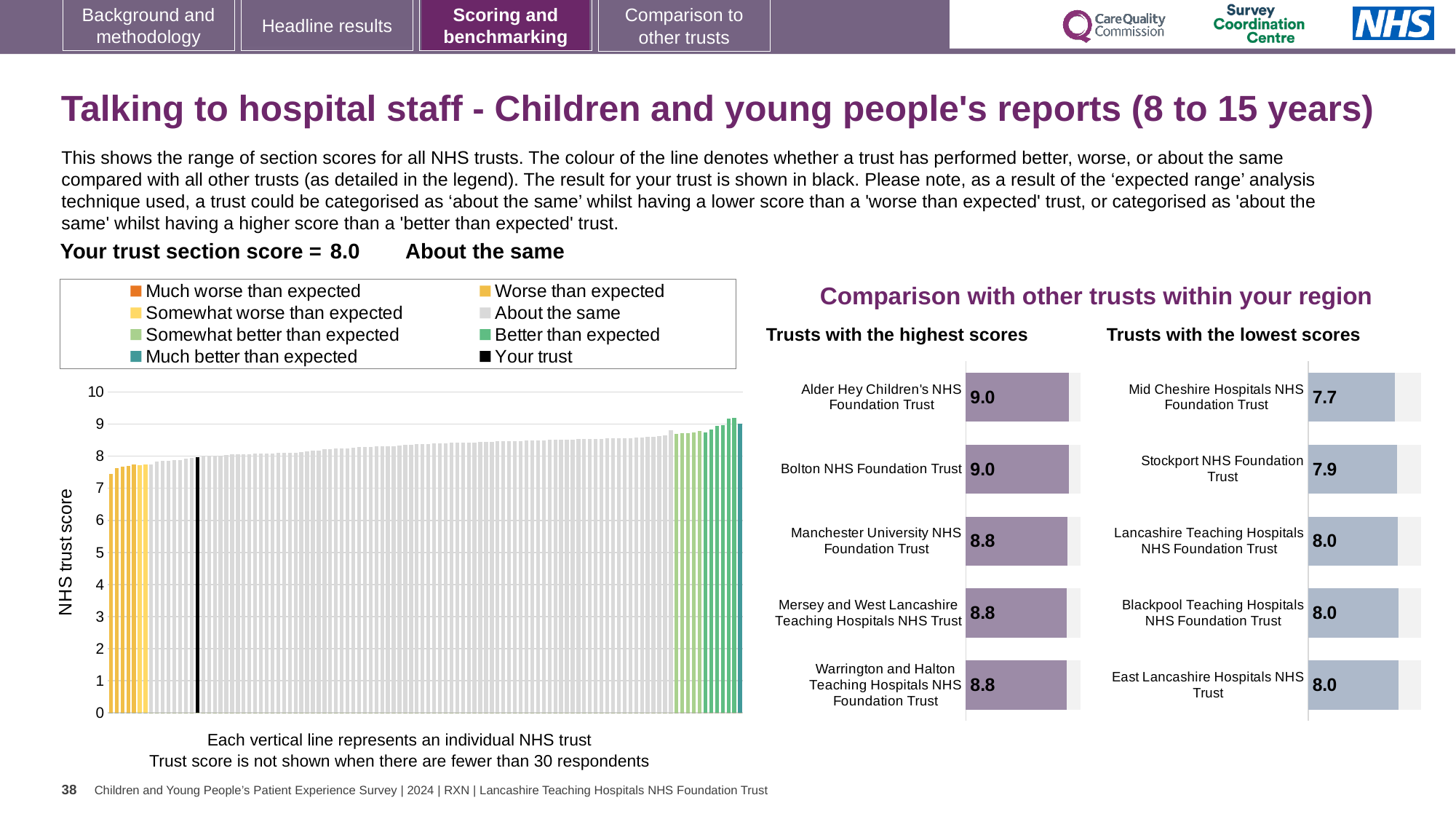
In the 'Trusts with the highest scores' chart, what is the score for Warrington and Halton Teaching Hospitals NHS Foundation Trust? 8.8 In the 'Trusts with the highest scores' chart, what is the score for Alder Hey Children's NHS Foundation Trust? 9.0 In the main chart on the left, what is the section score for your trust (the black bar)? 8.0 How many trusts are listed in the 'Trusts with the lowest scores' chart? 5 In the 'Trusts with the lowest scores' chart, what is the difference between the scores of Stockport NHS Foundation Trust and Mid Cheshire Hospitals NHS Foundation Trust? 0.2 In the 'Trusts with the lowest scores' chart, what is the score for Stockport NHS Foundation Trust? 7.9 In the 'Trusts with the lowest scores' chart, which trust has the lowest score? Mid Cheshire Hospitals NHS Foundation Trust In the main chart on the left, do the bar values rise or fall from left to right? rise In the 'Trusts with the highest scores' chart, which has the larger score: Bolton NHS Foundation Trust or Manchester University NHS Foundation Trust? Bolton NHS Foundation Trust In the main chart on the left, is the value of the leftmost bar greater or less than 8? less In the 'Trusts with the highest scores' chart, what is the difference between the scores of Alder Hey Children's NHS Foundation Trust and Mersey and West Lancashire Teaching Hospitals NHS Trust? 0.2 How many entries does the legend of the main chart on the left list? 8